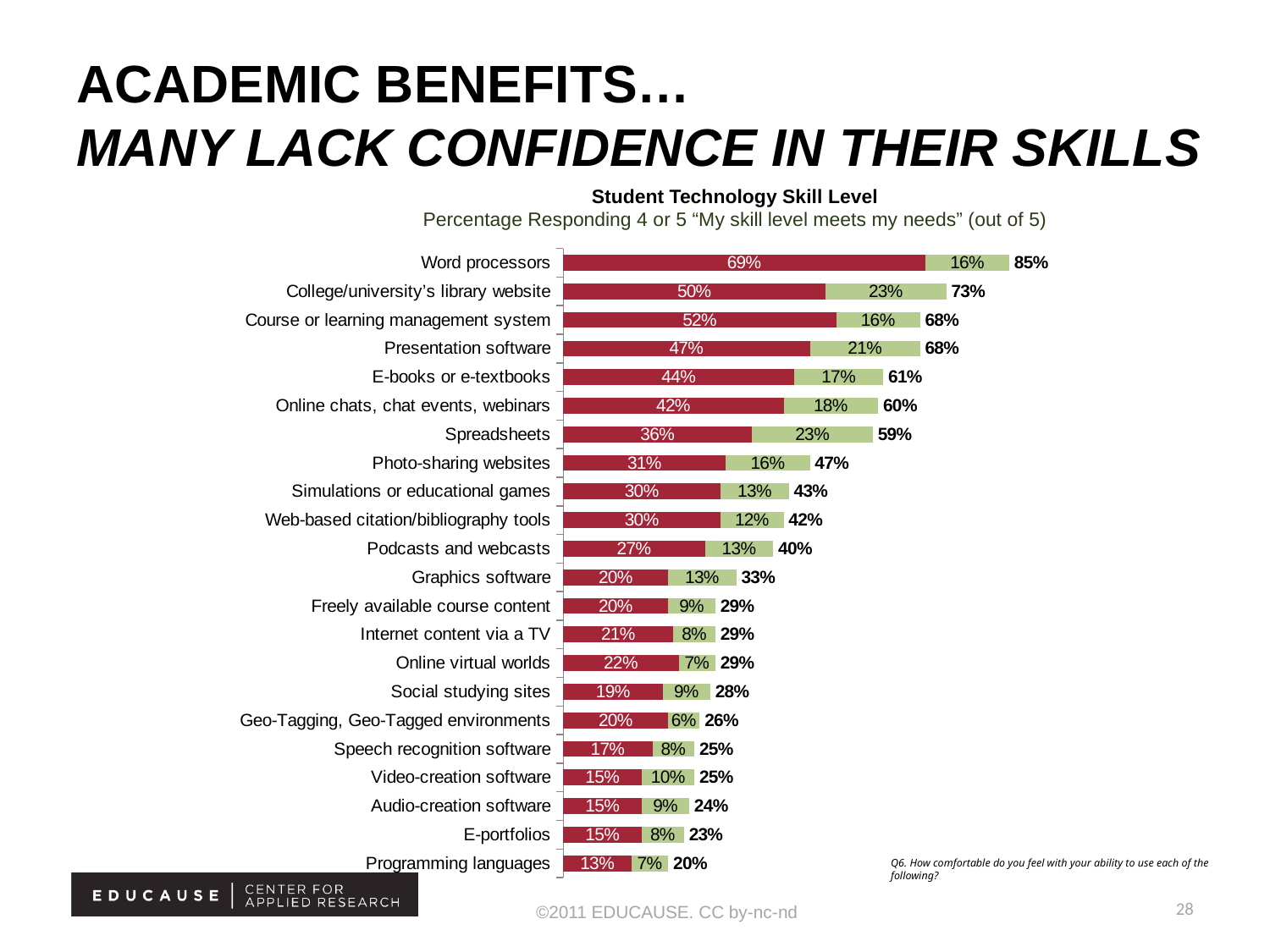
What is the total percentage shown for Video-creation software? 25% How many categories are shown in the chart? 22 What kind of chart is shown on the slide? Stacked bar chart What is the value of the green (second) segment for Presentation software? 21% Which has a larger total percentage, E-books or e-textbooks or Spreadsheets? E-books or e-textbooks What is the total percentage shown for Word processors? 85% Which category has the lowest total percentage? Programming languages What is the title of the chart? Student Technology Skill Level What is the value of the red (first) segment for Spreadsheets? 36% What is the difference between the total for Word processors and the total for Programming languages? 65% Which category has the highest total percentage? Word processors What is the sum of the two segments for Podcasts and webcasts? 40%